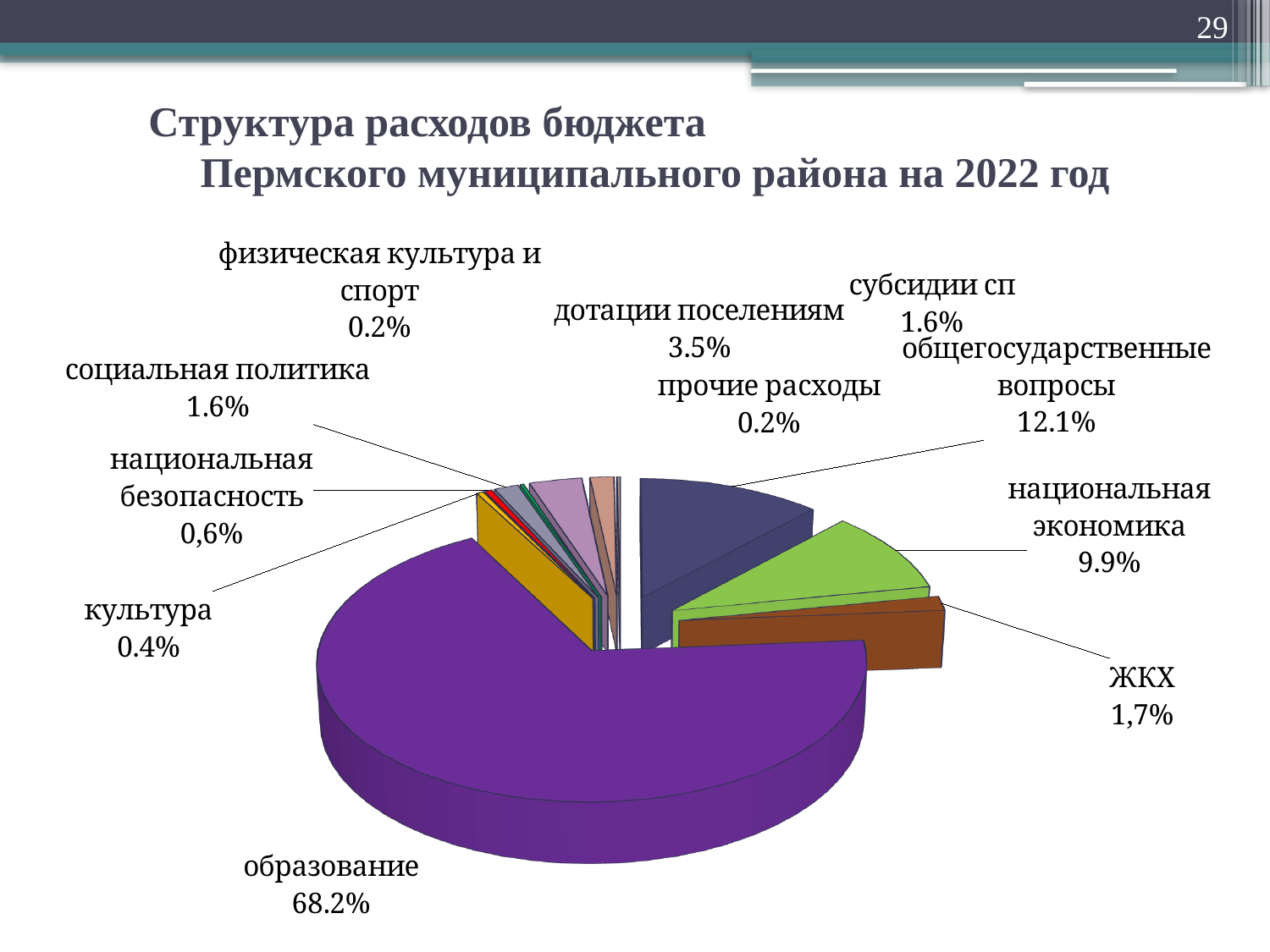
What year does the chart title refer to? 2022 By how many percentage points does the share for образование exceed the share for общегосударственные вопросы? 56.1 What is the share for общегосударственные вопросы? 12.1% What is the share for ЖКХ? 1,7% What share of budget expenditures goes to образование? 68.2% What is the share for национальная безопасность? 0,6% Which is larger: the share for национальная экономика or the share for общегосударственные вопросы? общегосударственные вопросы What is the share for дотации поселениям? 3.5% Which category has the largest share of the budget expenditures? образование What is the share for национальная экономика? 9.9% What type of chart is shown on the slide? pie chart How many categories are shown in the pie chart? 11